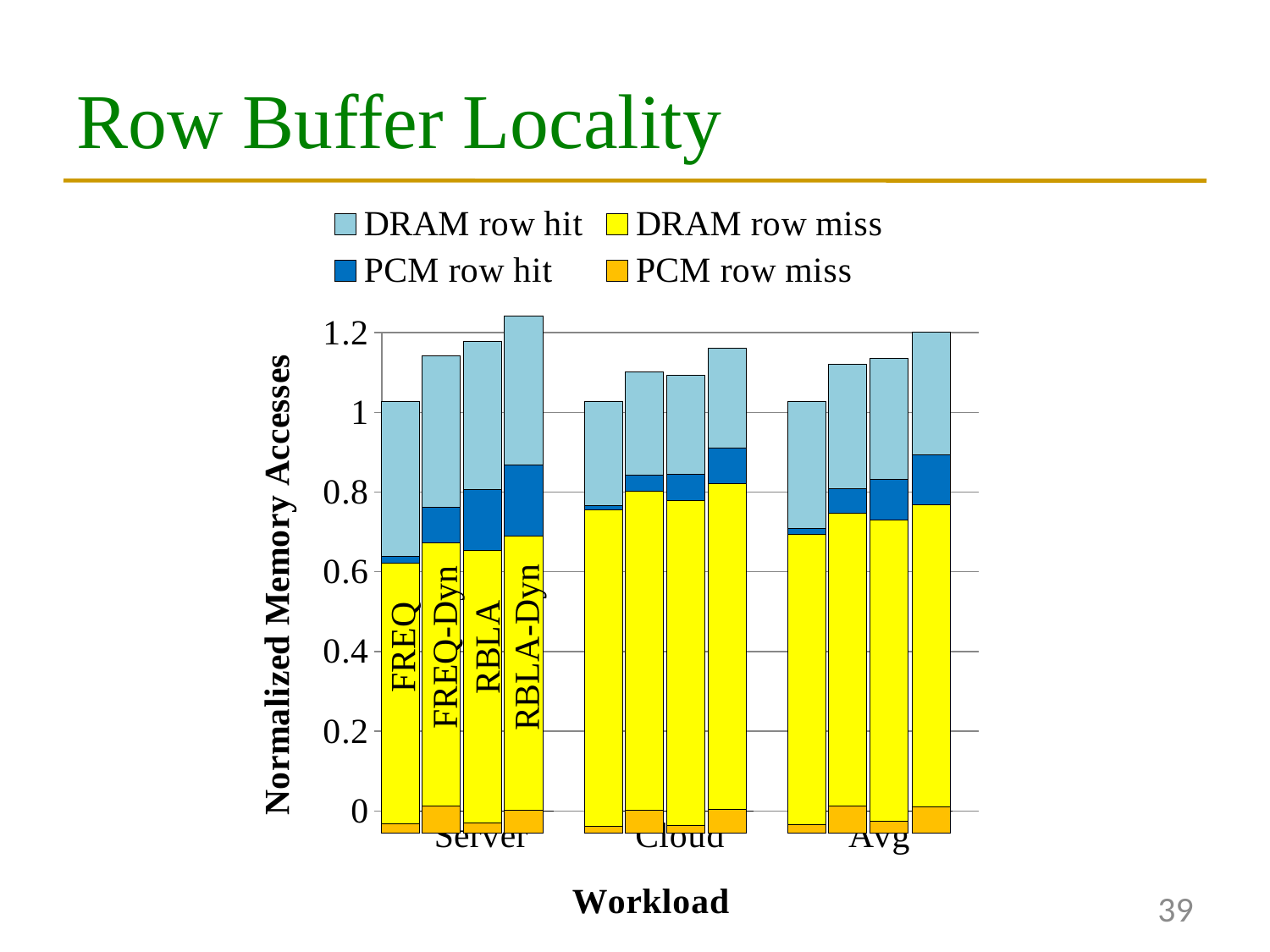
How many workload groups are shown on the x axis? 3 Which bar in the Server group has the lowest total? FREQ How many series does the legend list? 4 What kind of chart is shown on the slide? stacked bar chart Is the total for FREQ-Dyn in the Server group greater or less than 1? greater Which bar in the Cloud group has the highest total? RBLA-Dyn Is the total for RBLA-Dyn in the Cloud group greater or less than 1.2? less How many bars are shown for each workload group? 4 What is the title of the y axis? Normalized Memory Accesses Which bar in the Server group has the highest total? RBLA-Dyn Which is larger in the Server group, the total for FREQ or the total for RBLA-Dyn? RBLA-Dyn